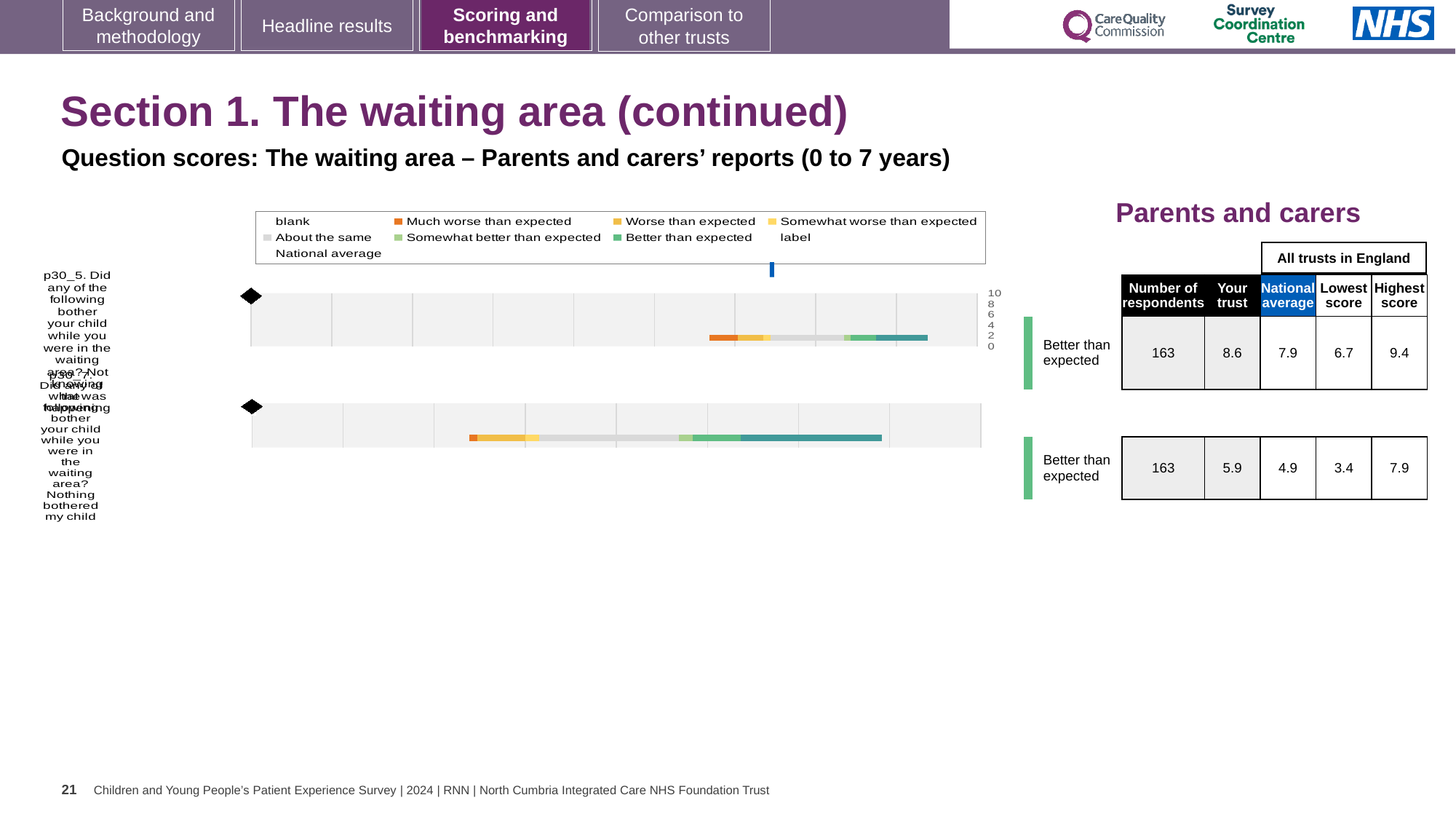
What is the national average score for question p30_5 (top bar)? 7.9 What kind of chart is used to show the question scores on this slide? bar chart Which question has the higher 'Your trust' score, p30_5 or p30_7? p30_5 What is the lowest score among all trusts in England for question p30_7 (bottom bar)? 3.4 What benchmark category is shown next to both bars in the chart? Better than expected What is the highest score among all trusts in England for question p30_5 (top bar)? 9.4 What is the difference between the highest and lowest trust scores for question p30_7? 4.5 How many questions (bars) are plotted in the chart? 2 By how much does the trust's score for p30_5 exceed the national average? 0.7 How many respondents answered question p30_5? 163 What is the 'Your trust' score for question p30_7 (bottom bar)? 5.9 What is the 'Your trust' score for question p30_5 (top bar)? 8.6